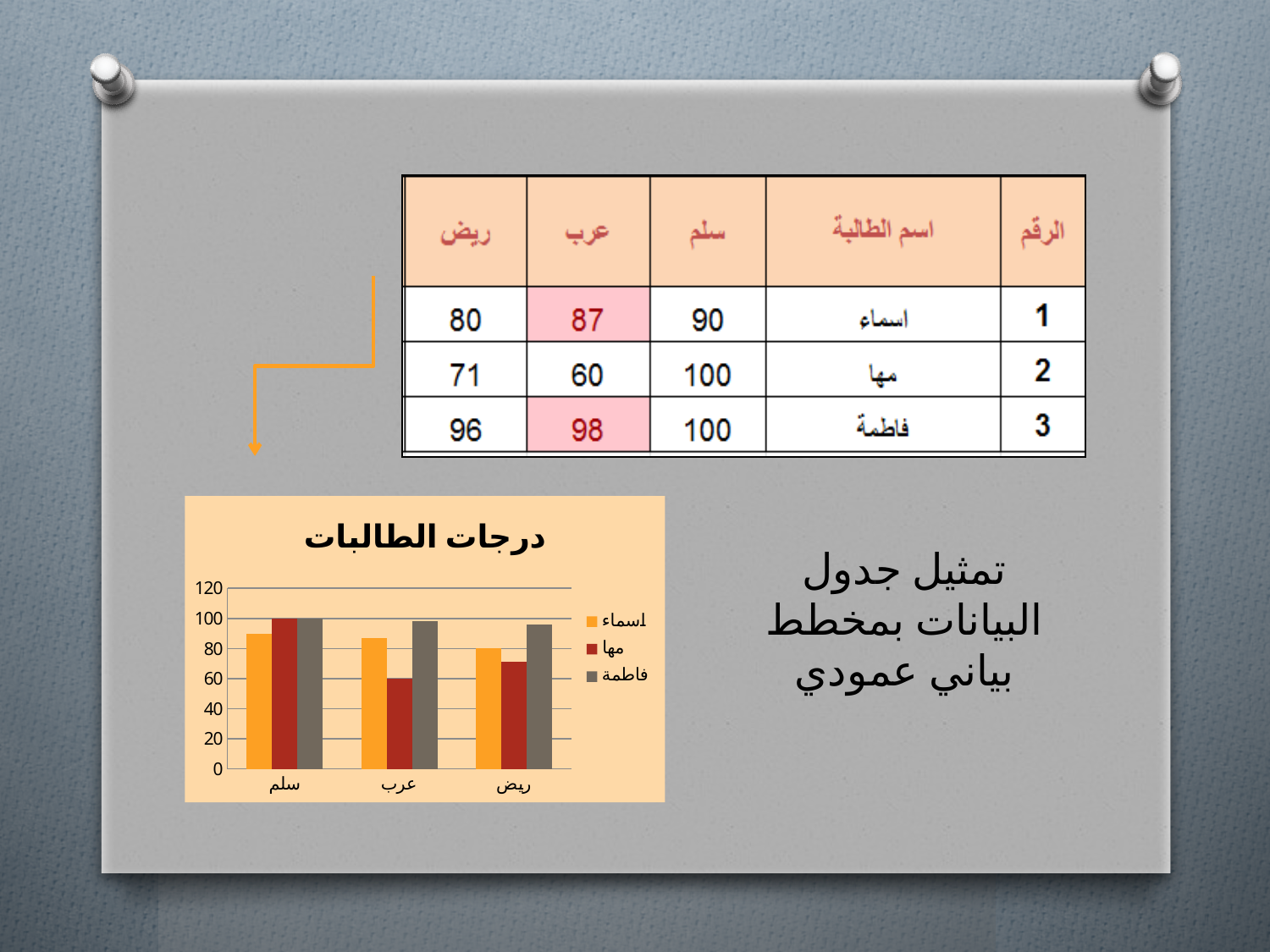
What kind of chart is shown on the slide? bar chart Which student has the highest value in the ريض category? فاطمة What is the title of the chart? درجات الطالبات What is the value for مها in the سلم category? 100 What is the value for فاطمة in the سلم category? 100 How many series does the chart legend list? 3 What is the value for اسماء in the عرب category? 87 How many categories are shown on the x axis of the chart? 3 Which student has the lowest value in the عرب category? مها Is the value for مها in the عرب category greater or less than 80? less In the ريض category, which is larger: the value for اسماء or the value for مها? اسماء Is the value for فاطمة in the ريض category greater or less than 80? greater